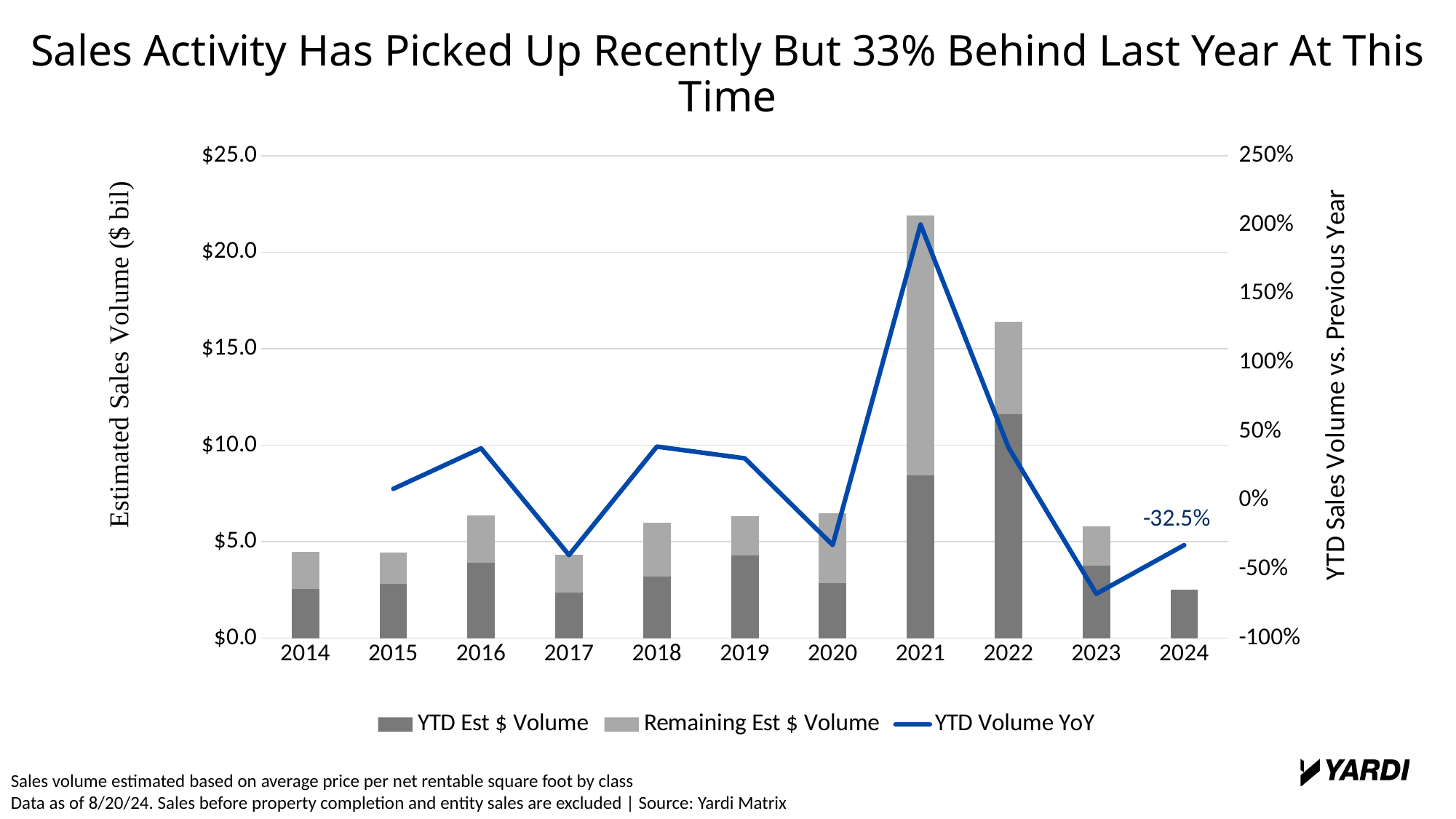
Is the total estimated sales volume for 2021 greater or less than $20.0 billion? greater Which year has the lowest total estimated sales volume bar? 2024 What kind of chart is shown on the slide? Stacked bar chart with a line Which year has the highest total estimated sales volume bar? 2021 What is the YTD Volume YoY value shown for 2024? -32.5% What is the title of the left vertical axis? Estimated Sales Volume ($ bil) Is the YTD Est $ Volume for 2022 greater or less than $10.0 billion? greater How many years are shown on the x axis? 11 Does the YTD Volume YoY line rise or fall from 2021 to 2023? fall How many series does the legend list? 3 Is the YTD Volume YoY for 2023 greater or less than -50%? less Which year has the highest YTD Est $ Volume? 2022